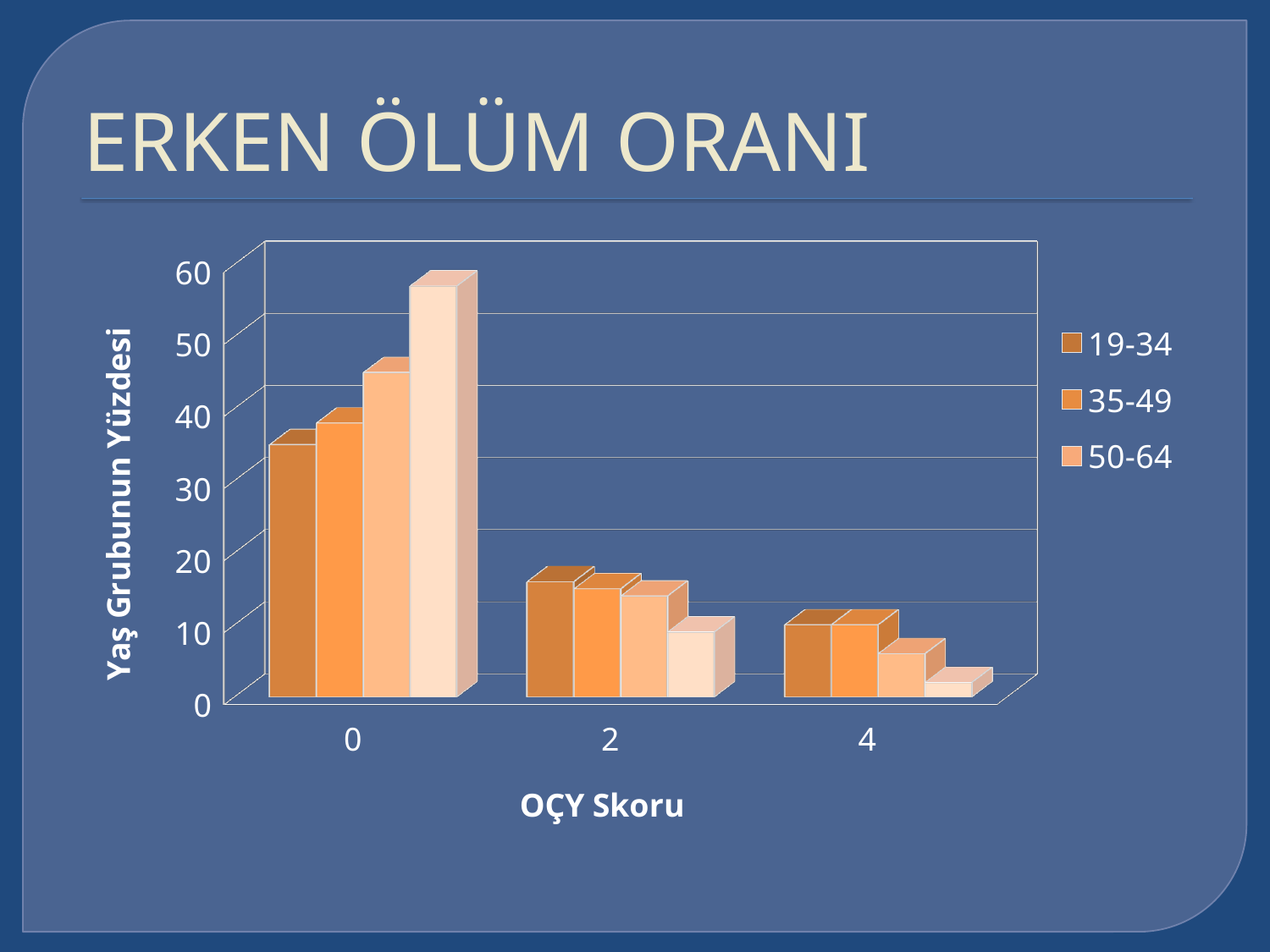
Is the value for the 50-64 group at OÇY Skoru 4 greater or less than 10? less Is the value for the 19-34 group at OÇY Skoru 2 greater or less than 20? less What is the title of the vertical axis? Yaş Grubunun Yüzdesi At OÇY Skoru 0, which is larger: the value for the 19-34 group or the 50-64 group? 50-64 For the 19-34 group, which is larger: the value at OÇY Skoru 0 or at OÇY Skoru 4? OÇY Skoru 0 For the 50-64 group, do the values rise or fall as the OÇY Skoru increases from 0 to 4? fall What kind of chart is shown on the slide? bar chart For the 35-49 group, at which OÇY Skoru is the value highest? 0 Is the value for the 50-64 group at OÇY Skoru 0 greater or less than 40? greater How many series does the legend list? 3 How many OÇY Skoru categories are shown on the x axis? 3